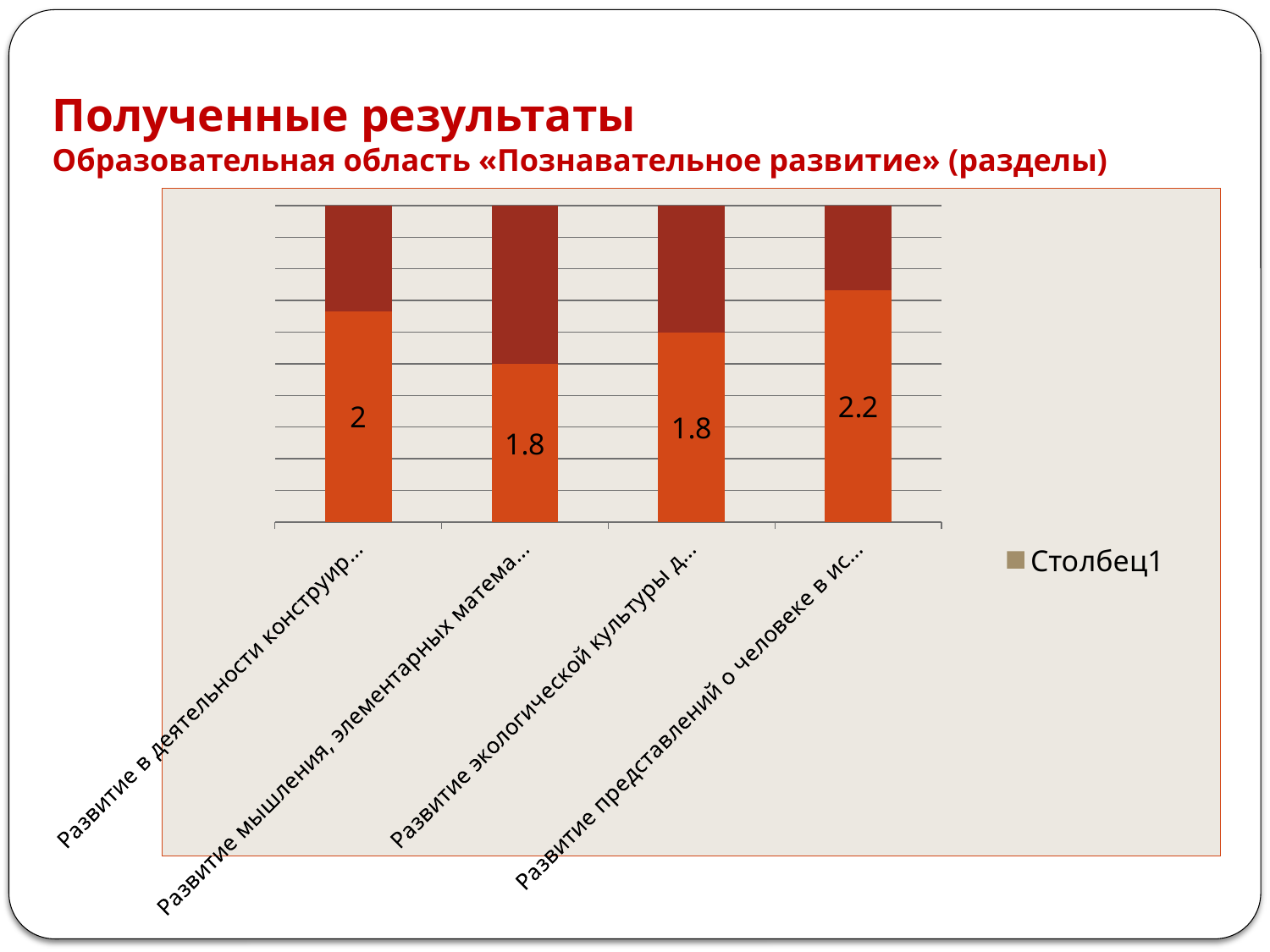
How many entries does the legend list? 1 What kind of chart is shown on the slide? Bar chart What is the labelled value for the bar 'Развитие в деятельности конструир...'? 2 How many bars (categories) are shown on the chart? 4 What is the difference between the labelled values for 'Развитие представлений о человеке в ис...' and 'Развитие в деятельности конструир...'? 0.2 What is the labelled value for the bar 'Развитие представлений о человеке в ис...'? 2.2 Which category has the highest labelled value? Развитие представлений о человеке в ис... What is the legend entry shown on the chart? Столбец1 What is the lowest labelled value shown on the chart? 1.8 What is the labelled value for the bar 'Развитие экологической культуры д...'? 1.8 What is the labelled value for the bar 'Развитие мышления, элементарных матема...'? 1.8 Which has the larger labelled value: 'Развитие в деятельности конструир...' or 'Развитие мышления, элементарных матема...'? Развитие в деятельности конструир...